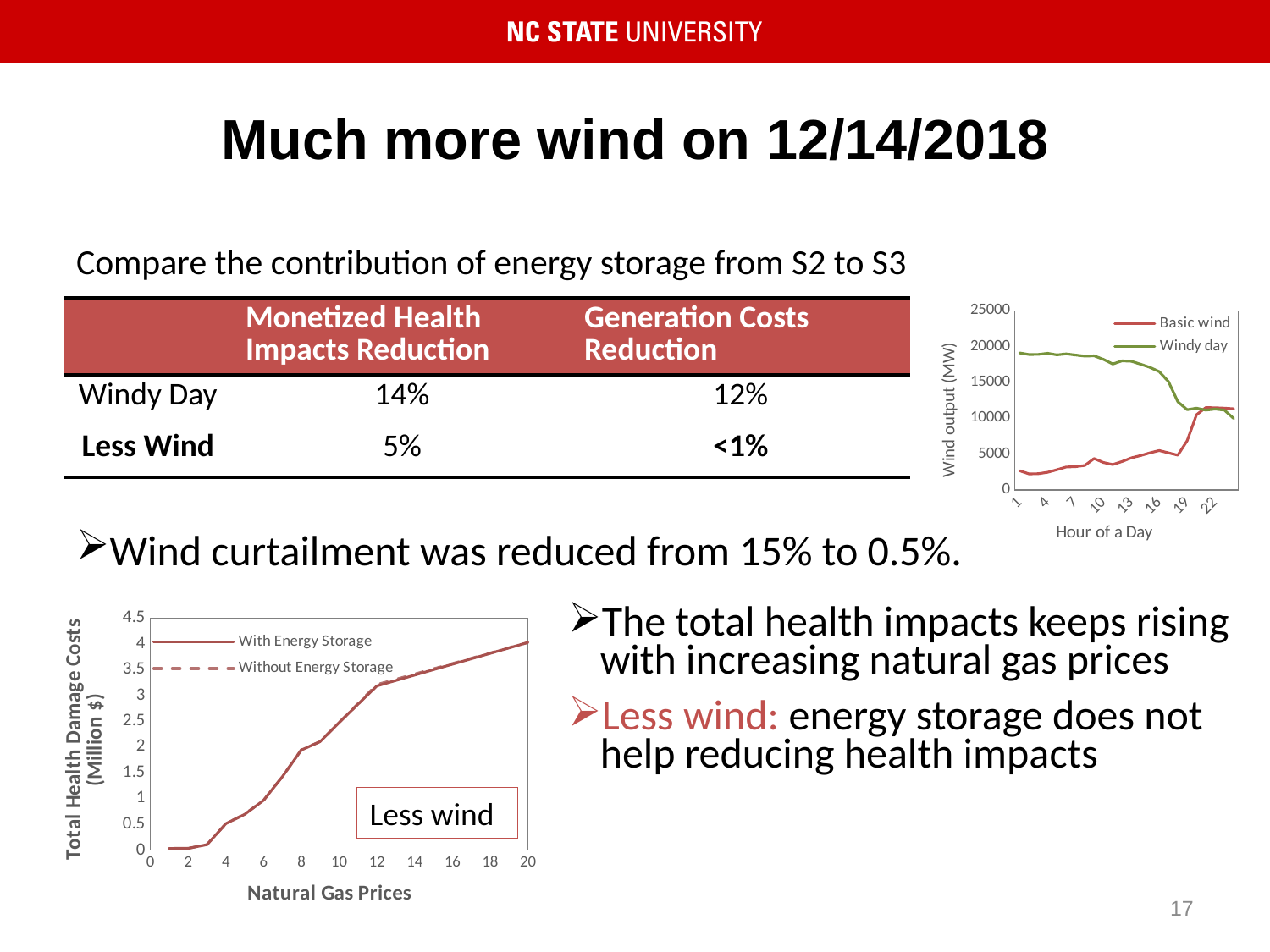
In the top-right chart, does the Basic wind series rise or fall over the hours of the day? rise In the top-right chart, what are the two series named in the legend? Basic wind, Windy day In the top-right chart, is the Windy day wind output at hour 1 greater or less than 15000? greater What kind of chart is the bottom-left chart with the x axis 'Natural Gas Prices'? line chart In the top-right chart, which series has the higher wind output at hour 7, Basic wind or Windy day? Windy day In the bottom-left chart, is the total health damage cost at a natural gas price of 12 greater or less than 3? greater How many series does the legend of the bottom-left 'Natural Gas Prices' chart list? 2 In the top-right chart, does the Windy day series rise or fall over the hours of the day? fall How many series does the legend of the 'Hour of a Day' chart in the top right list? 2 In the bottom-left chart, do the total health damage costs rise or fall as natural gas prices increase? rise What kind of chart is the chart in the top right with the x axis 'Hour of a Day'? line chart In the top-right chart, is the Basic wind output at hour 1 greater or less than 5000? less